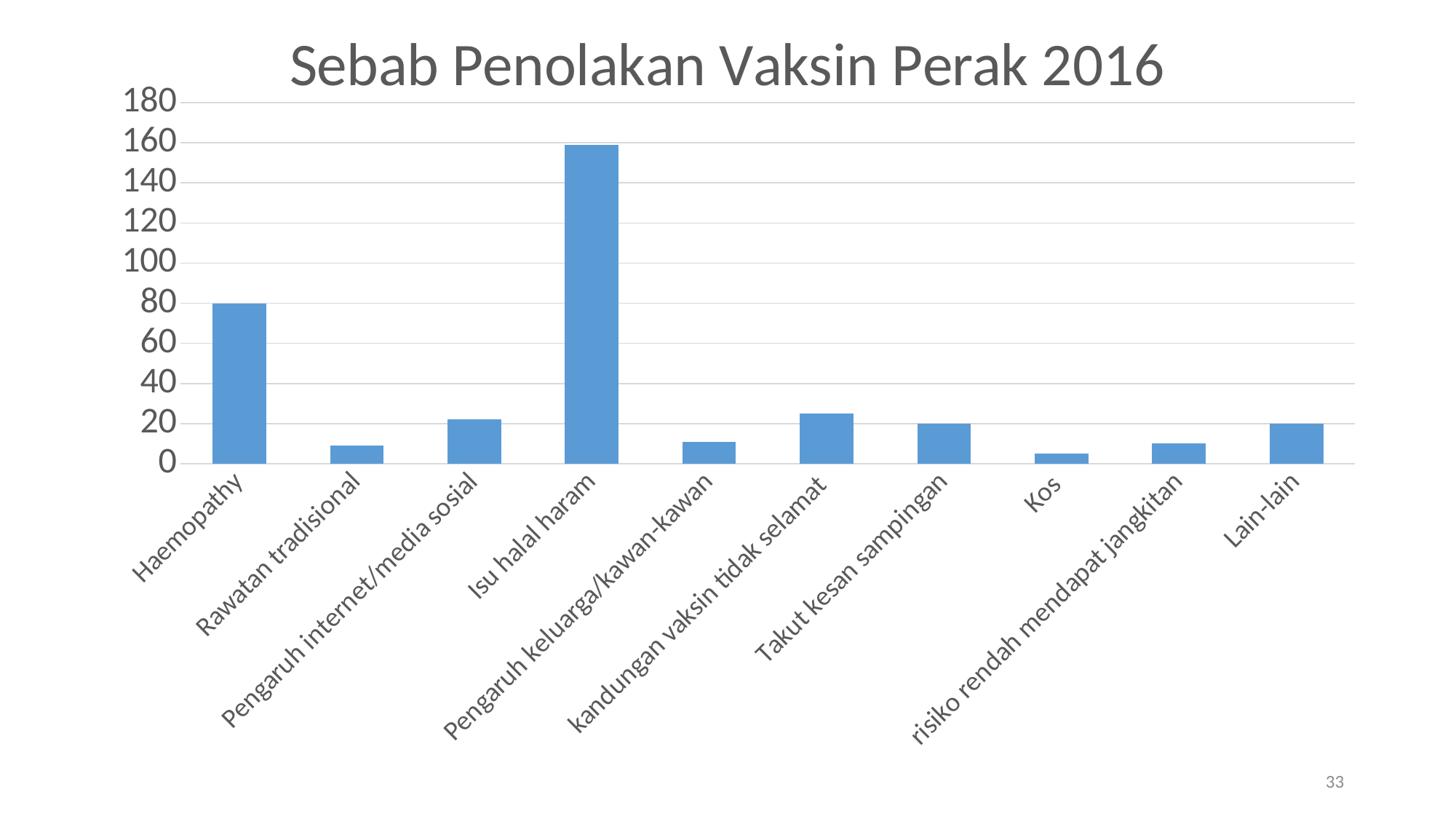
Is the value for Kos greater or less than 20? less Is the value for Isu halal haram greater or less than 140? greater How many categories are shown on the x axis of the chart? 10 Which is larger, the value for Haemopathy or the value for Isu halal haram? Isu halal haram What is the title of the chart? Sebab Penolakan Vaksin Perak 2016 What type of chart is shown on the slide? Bar chart Is the value for Haemopathy greater or less than 100? less What is the value for Haemopathy? 80 Which category has the highest value in the chart? Isu halal haram Which category has the lowest value in the chart? Kos Which is larger, the value for kandungan vaksin tidak selamat or the value for Rawatan tradisional? kandungan vaksin tidak selamat